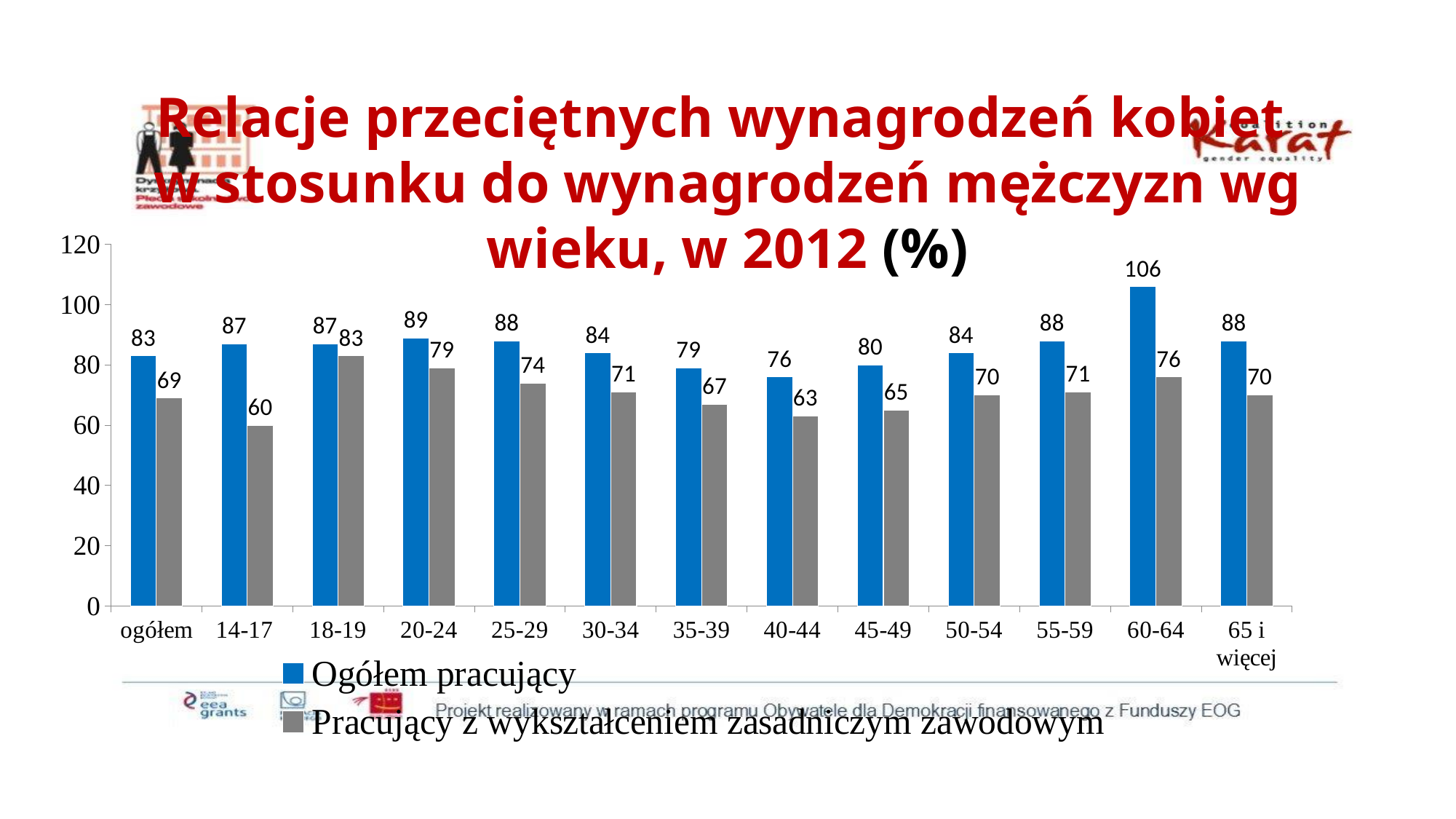
What is the difference between the 'Ogółem pracujący' and 'Pracujący z wykształceniem zasadniczym zawodowym' values in the 14-17 age group? 27 Which is larger: the 'Ogółem pracujący' value for 40-44 or for 45-49? 45-49 What is the value for 'Pracujący z wykształceniem zasadniczym zawodowym' in the 14-17 age group? 60 What is the value for 'Ogółem pracujący' in the 60-64 age group? 106 Which colour represents 'Ogółem pracujący' in the chart? blue How many categories are shown on the x axis? 13 What kind of chart is shown on the slide? bar chart Which category has the lowest value for 'Pracujący z wykształceniem zasadniczym zawodowym'? 14-17 Is the 'Ogółem pracujący' value for 60-64 greater or less than 100? greater What is the value for 'Ogółem pracujący' for the 'ogółem' category? 83 How many series does the legend list? 2 Which age group has the highest value for 'Ogółem pracujący'? 60-64